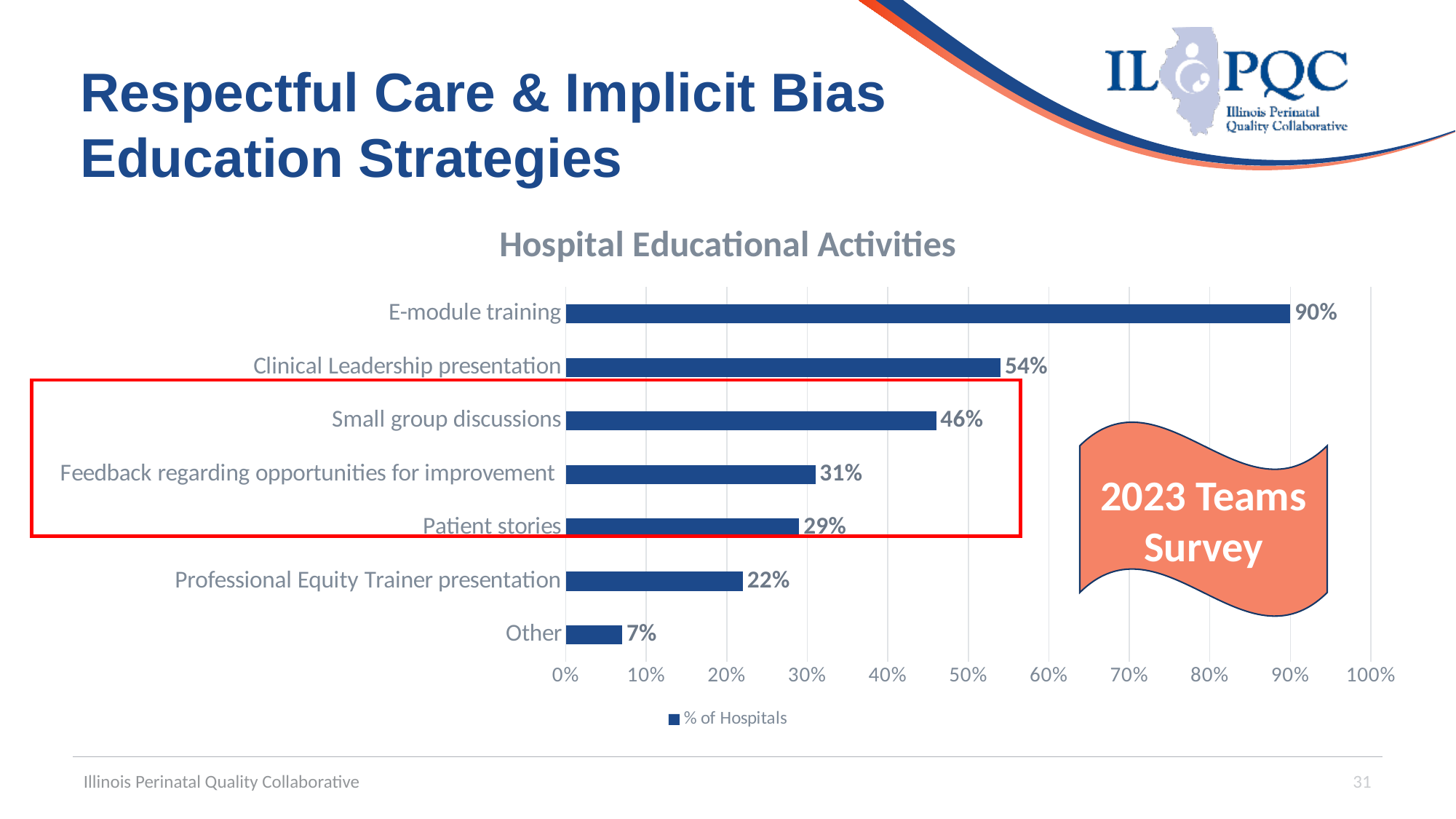
What percentage of hospitals reported Feedback regarding opportunities for improvement? 31% Which category has the lowest value? Other What kind of chart is shown? bar chart What is the difference between Clinical Leadership presentation and Small group discussions? 8% What is the value for Patient stories? 29% How many categories are shown in the chart? 7 What is the title of the chart? Hospital Educational Activities Which is larger: Professional Equity Trainer presentation or Patient stories? Patient stories Which educational activity has the highest percentage of hospitals? E-module training How many series does the legend list? 1 Is the value for Small group discussions greater or less than 50%? less What percentage of hospitals reported E-module training? 90%